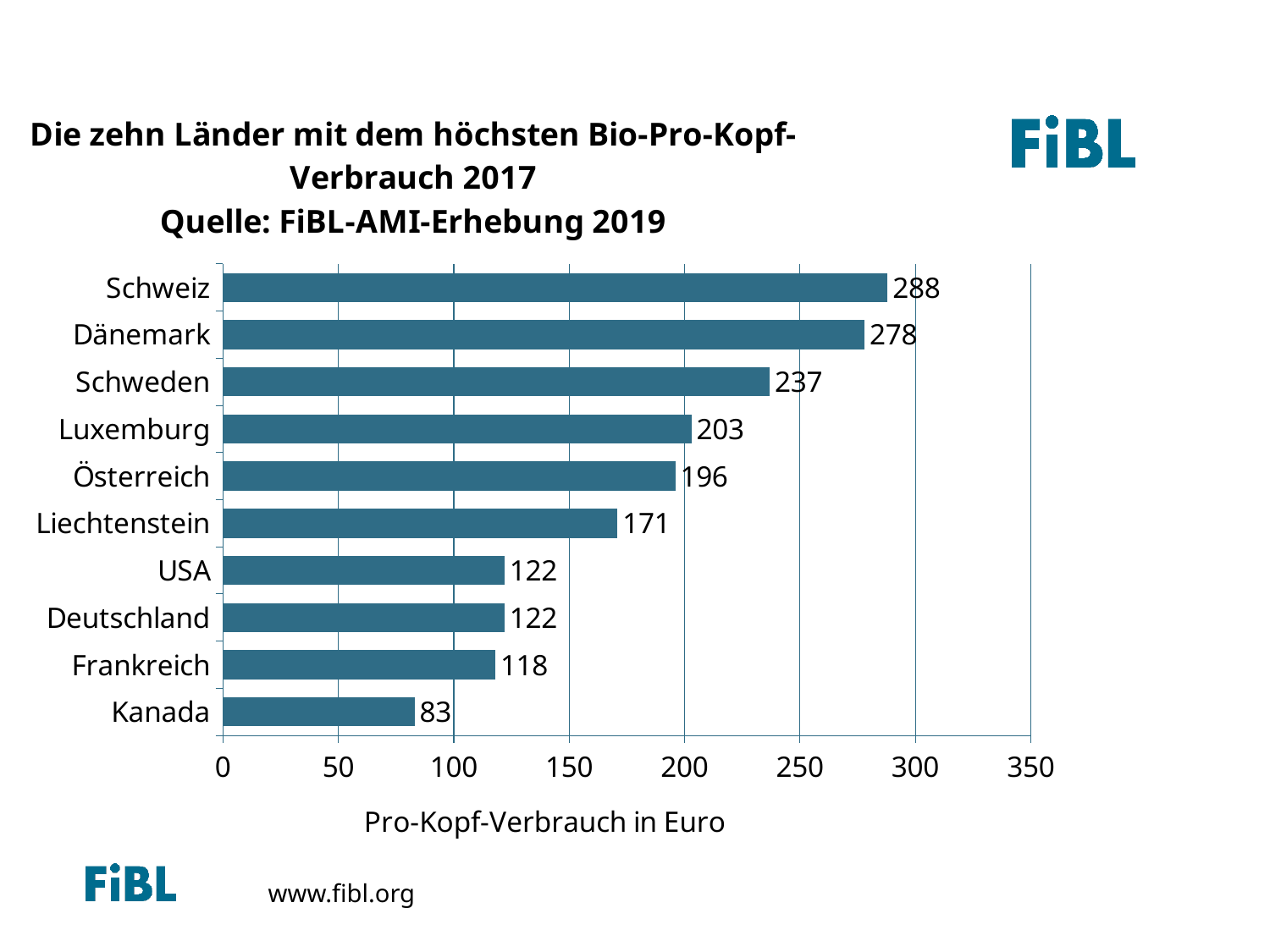
Which country has the highest per-capita organic consumption in the chart? Schweiz What is the label of the horizontal axis? Pro-Kopf-Verbrauch in Euro What kind of chart is shown on the slide? bar chart What value is shown for Liechtenstein? 171 Is the value for Frankreich greater or less than 150? less What is the difference between the values for Luxemburg and Österreich? 7 Which has a larger value, Schweden or Luxemburg? Schweden What is the difference between the values for Schweiz and Dänemark? 10 How many countries are shown in the chart? 10 What is the per-capita organic consumption value shown for Schweden? 237 Which country has the lowest value in the chart? Kanada What value is shown for Kanada? 83